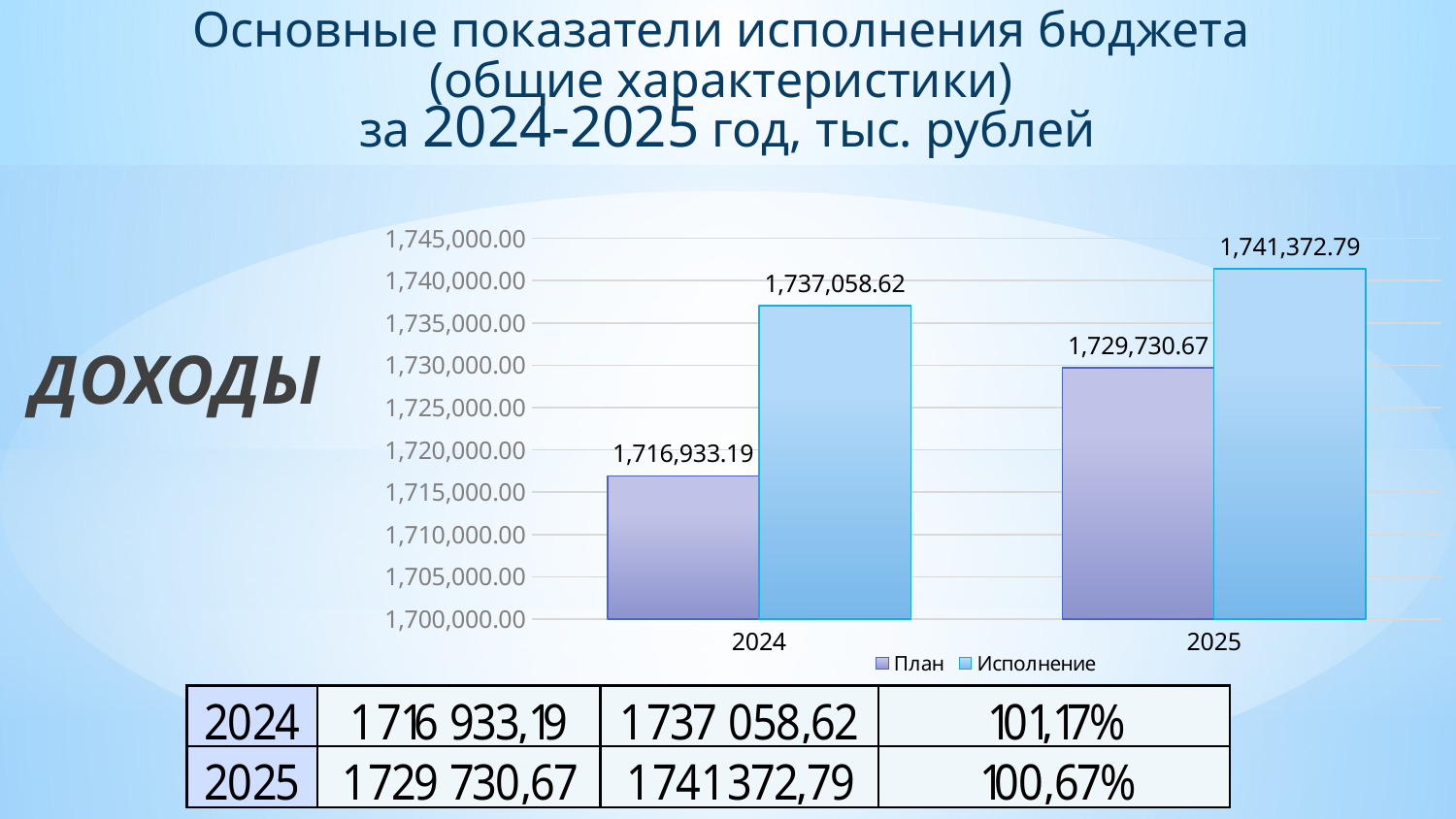
What is the value of Исполнение for 2024? 1,737,058.62 Which is larger, План for 2025 or Исполнение for 2024? Исполнение for 2024 What is the difference between Исполнение and План for 2025? 11,642.12 What kind of chart is shown on the slide? Bar chart What is the difference between Исполнение and План for 2024? 20,125.43 What is the value of Исполнение for 2025? 1,741,372.79 How many series does the legend list? 2 Which bar has the highest value on the chart? Исполнение 2025 What is the value of План for 2025? 1,729,730.67 What is the value of План for 2024? 1,716,933.19 Does the value of План rise or fall from 2024 to 2025? Rise Which bar has the lowest value on the chart? План 2024